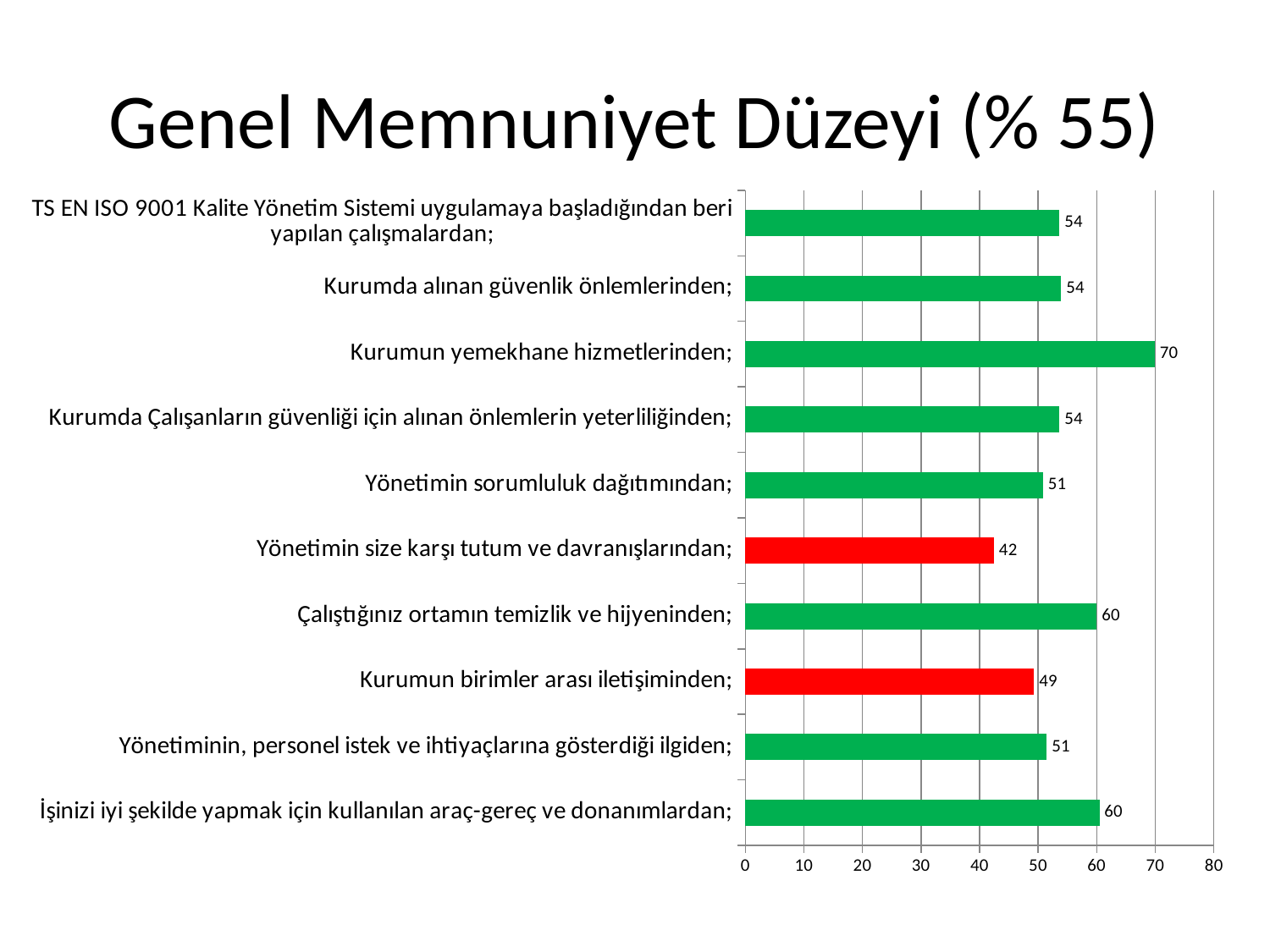
What is the difference between the values for "Kurumun yemekhane hizmetlerinden;" and "Yönetimin size karşı tutum ve davranışlarından;"? 28 What kind of chart is shown on the slide? bar chart How many bars are coloured red? 2 How many categories are shown in the chart? 10 What is the value for "Yönetimin size karşı tutum ve davranışlarından;"? 42 What is the value for "Çalıştığınız ortamın temizlik ve hijyeninden;"? 60 Which category has the lowest value? Yönetimin size karşı tutum ve davranışlarından; Which is larger: the value for "Kurumda alınan güvenlik önlemlerinden;" or the value for "Kurumun birimler arası iletişiminden;"? Kurumda alınan güvenlik önlemlerinden; Which category has the highest value? Kurumun yemekhane hizmetlerinden; What is the value for "Kurumun yemekhane hizmetlerinden;"? 70 Is the value for "Yönetimin sorumluluk dağıtımından;" greater or less than 40? greater What is the value for "Kurumun birimler arası iletişiminden;"? 49